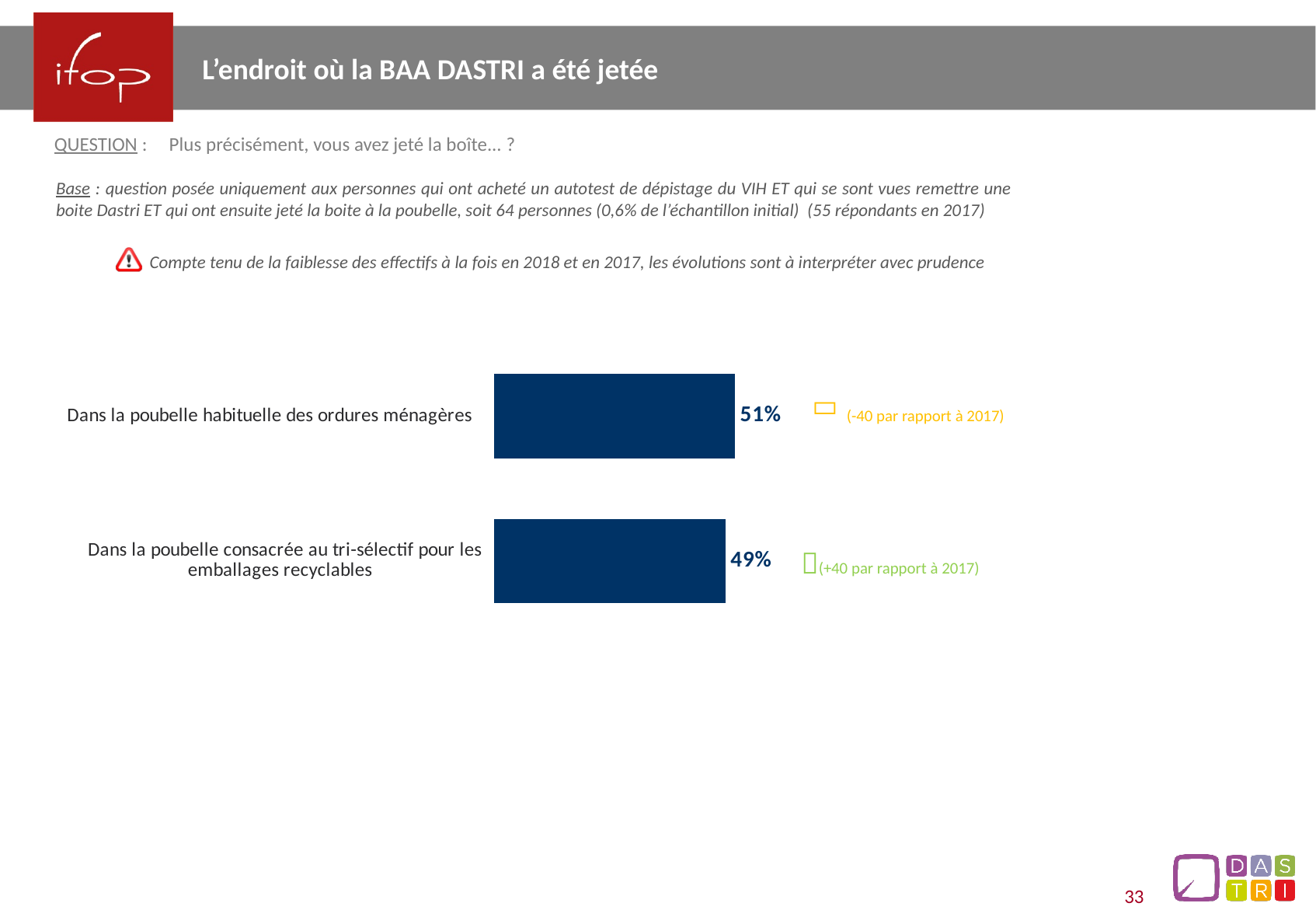
Which category has the highest value? Dans la poubelle habituelle des ordures ménagères Which category has the lowest value? Dans la poubelle consacrée au tri-sélectif pour les emballages recyclables What kind of chart is shown on the slide? Bar chart What is the total of the two values shown in the chart? 100% What is the difference between the value for "Dans la poubelle habituelle des ordures ménagères" and the value for "Dans la poubelle consacrée au tri-sélectif pour les emballages recyclables"? 2 points What is the value for "Dans la poubelle habituelle des ordures ménagères"? 51% How many categories are shown in the chart? 2 Which is larger: the value for "Dans la poubelle habituelle des ordures ménagères" or the value for "Dans la poubelle consacrée au tri-sélectif pour les emballages recyclables"? Dans la poubelle habituelle des ordures ménagères What is the value for "Dans la poubelle consacrée au tri-sélectif pour les emballages recyclables"? 49% What change compared to 2017 is noted next to "Dans la poubelle consacrée au tri-sélectif pour les emballages recyclables"? +40 par rapport à 2017 What change compared to 2017 is noted next to "Dans la poubelle habituelle des ordures ménagères"? -40 par rapport à 2017